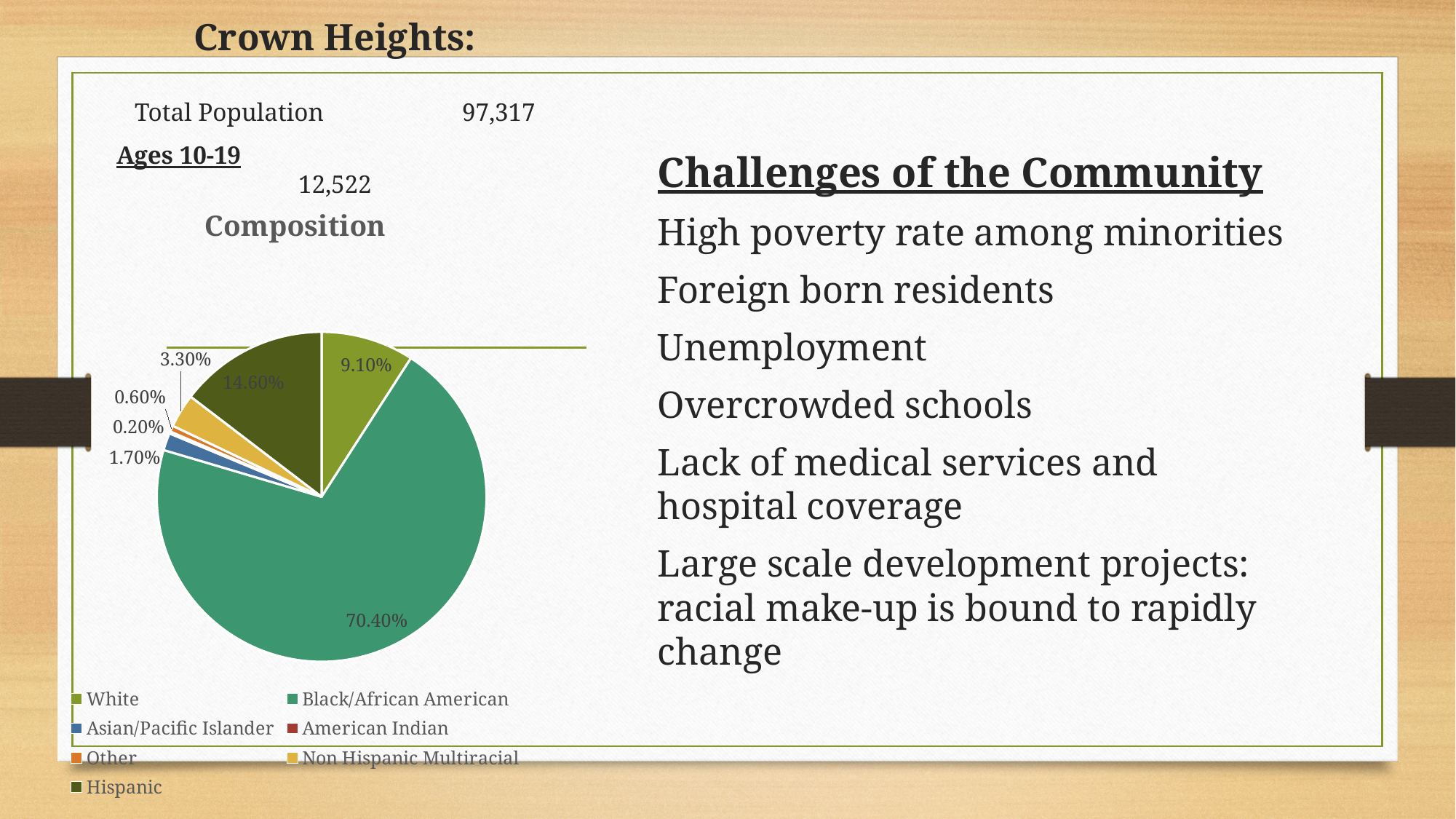
Which category has the smallest slice of the pie? American Indian Which is larger, the Hispanic slice or the White slice? Hispanic What percentage of the pie is Asian/Pacific Islander? 1.70% What percentage of the pie is Hispanic? 14.60% What kind of chart is shown on the slide? pie chart Which category has the largest slice of the pie? Black/African American What is the difference in percentage points between the Black/African American slice and the Hispanic slice? 55.80% What percentage of the pie is Black/African American? 70.40% How many categories does the legend list? 7 What percentage of the pie is Non Hispanic Multiracial? 3.30% What percentage of the pie is White? 9.10% What is the title of the chart? Composition